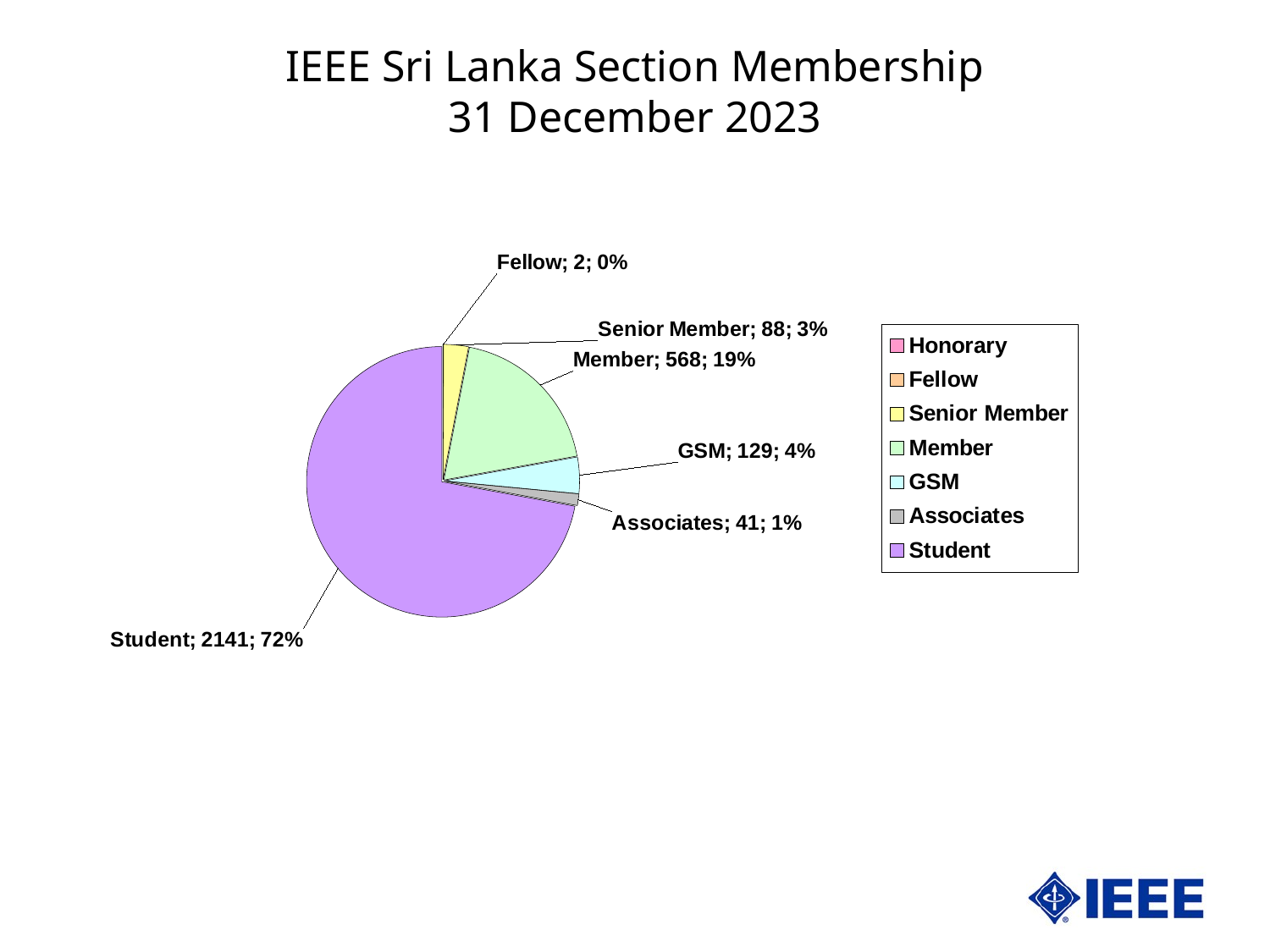
Among the labelled slices, which category has the smallest value? Fellow What is the value shown for GSM? 129 Which category has the largest slice of the pie? Student How many entries does the legend list? 7 What is the value shown for Member? 568 What percentage share of the pie does the Member slice represent? 19% What percentage share of the pie does the Student slice represent? 72% What is the difference between the Member value and the GSM value? 439 How many members are in the Student category? 2141 What type of chart is shown on the slide? Pie chart Which is larger, the value for Associates or the value for Senior Member? Senior Member What is the value shown for Senior Member? 88